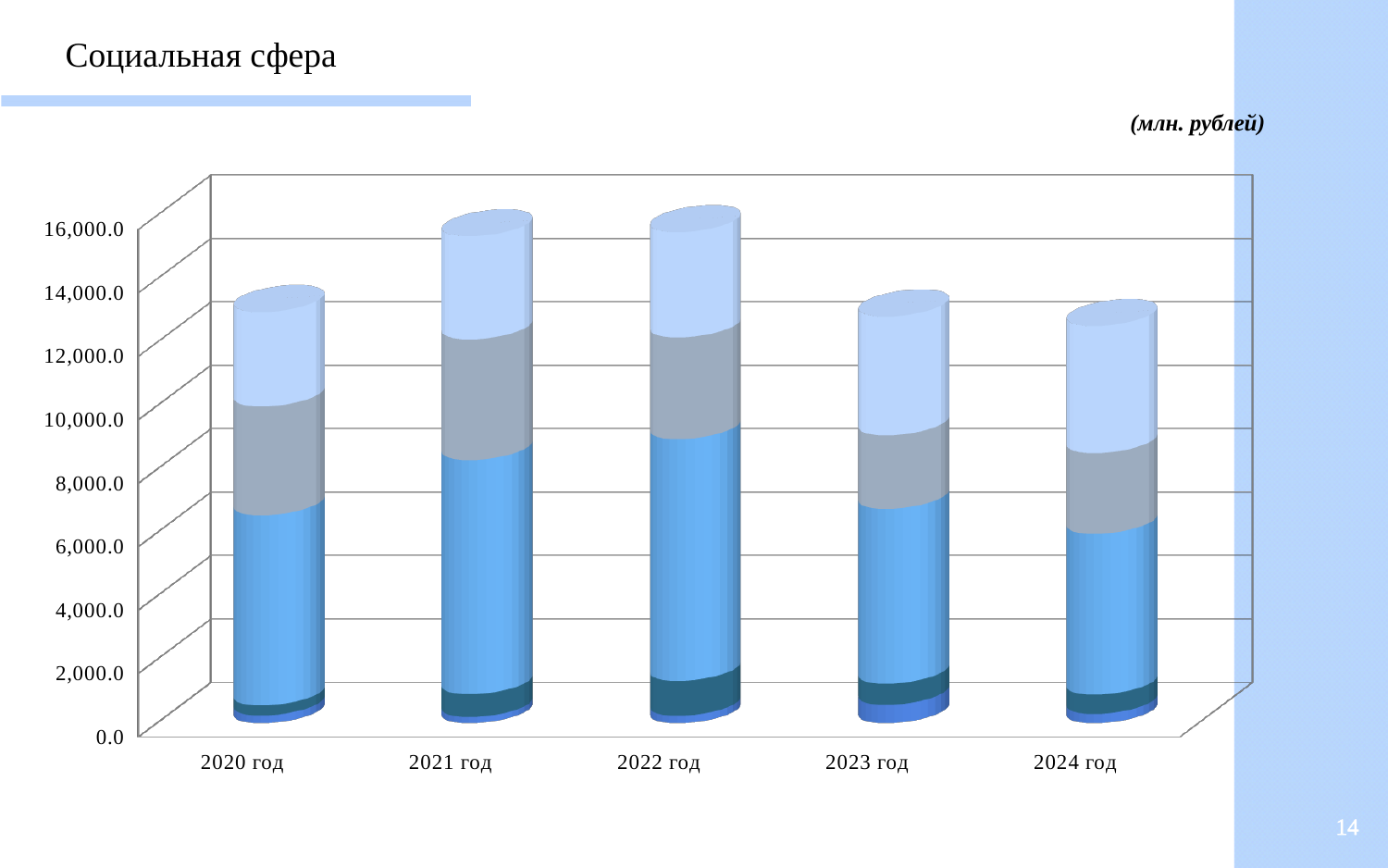
Is the total value of the bar for 2024 год greater or less than 12,000.0? greater Which bar is taller in total, 2022 год or 2023 год? 2022 год What is the title of the slide containing the chart? Социальная сфера What kind of chart is shown on the slide? Stacked bar chart How many years (categories) are shown on the x axis of the chart? 5 In what units are the values on the chart expressed, according to the note above the chart? млн. рублей Is the total value of the bar for 2021 год greater or less than 14,000.0? greater Do the total bar values rise or fall from 2022 год to 2024 год? fall Is the total value of the bar for 2023 год greater or less than 14,000.0? less Which bar is taller in total, 2020 год or 2021 год? 2021 год